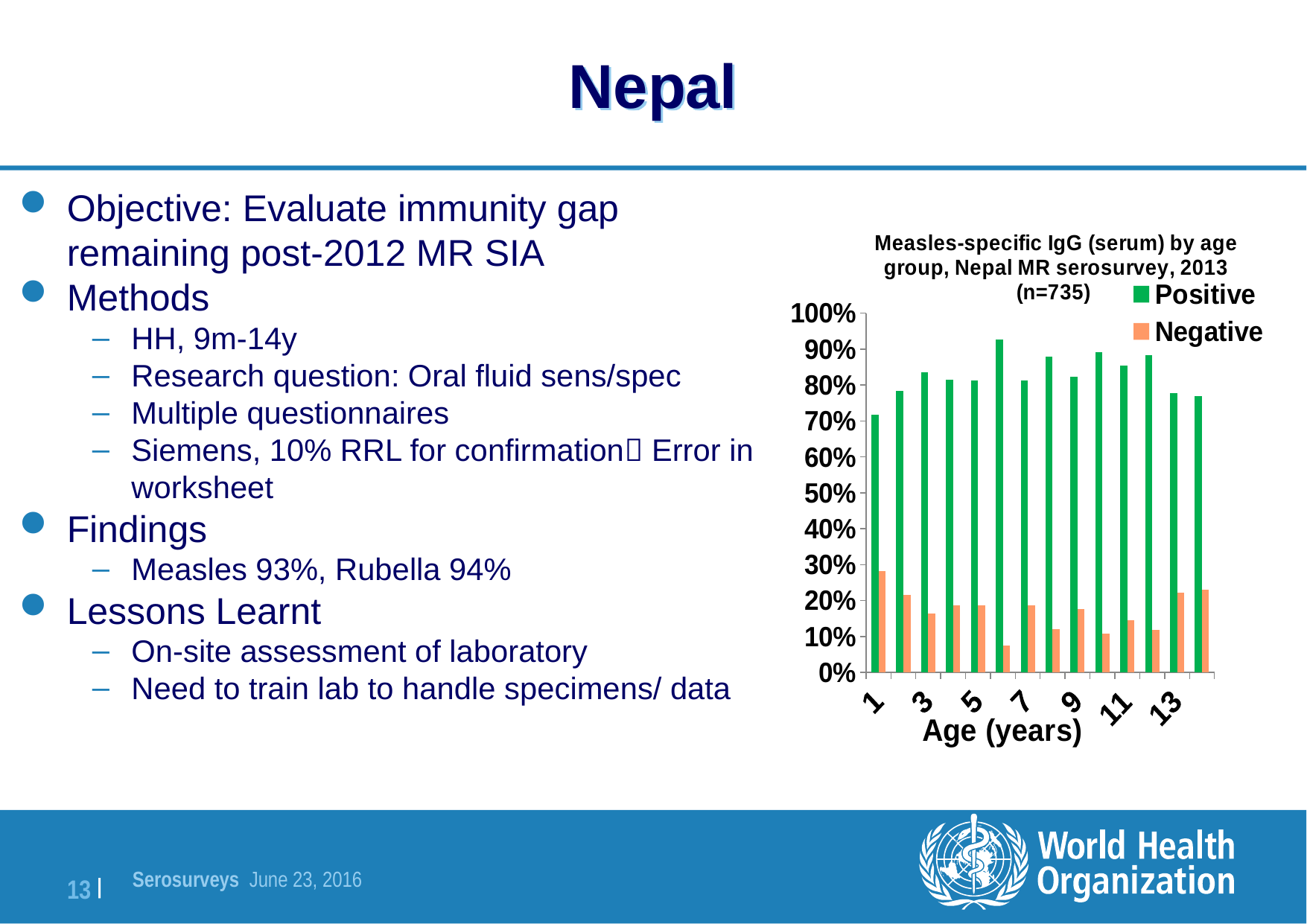
What is the x-axis label of the chart? Age (years) What are the two series named in the chart legend? Positive and Negative At which age is the Positive value lowest? 1 Is the Negative value for age 1 greater or less than 20%? greater What kind of chart is shown on the slide? Bar chart At which age is the Positive value highest? 6 At which age is the Negative value lowest? 6 Which is larger, the Positive value for age 6 or the Positive value for age 1? Age 6 How many age groups are plotted in the chart? 14 Is the Positive value for age 6 greater or less than 90%? greater At which age is the Negative value highest? 1 How many series does the chart legend list? 2